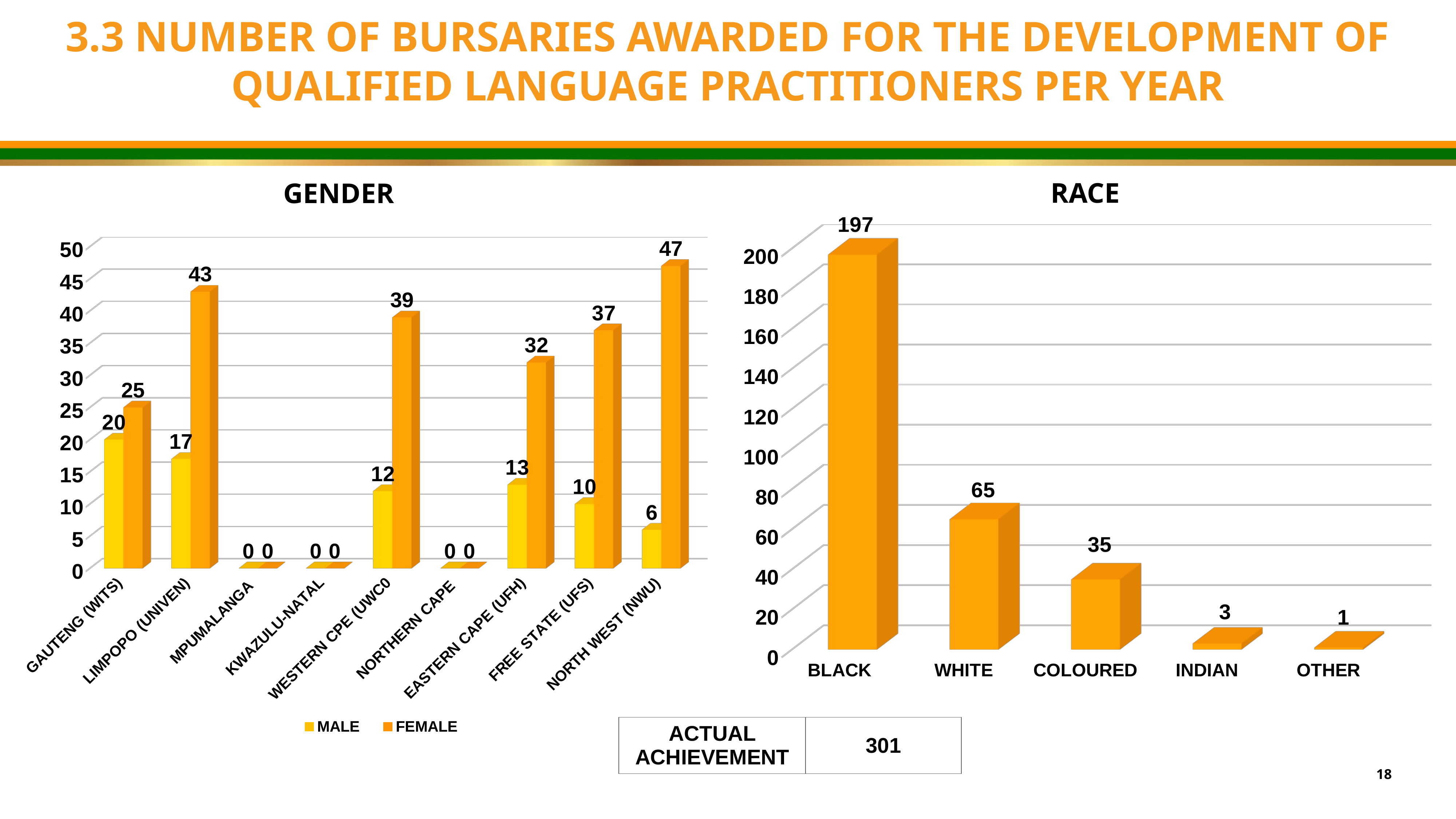
In the GENDER chart, what is the MALE value for GAUTENG (WITS)? 20 In the GENDER chart, which category has the highest FEMALE value? NORTH WEST (NWU) In the RACE chart, which category has the lowest value? OTHER In the RACE chart, what is the value for WHITE? 65 How many series does the legend of the GENDER chart list? 2 What kind of chart is the RACE chart? Bar chart In the GENDER chart, which is larger: the MALE value for EASTERN CAPE (UFH) or the MALE value for FREE STATE (UFS)? EASTERN CAPE (UFH) How many categories are shown on the x axis of the GENDER chart? 9 In the GENDER chart, what is the difference between the FEMALE and MALE values for LIMPOPO (UNIVEN)? 26 In the RACE chart, what is the difference between the values for BLACK and COLOURED? 162 In the GENDER chart, what is the FEMALE value for NORTH WEST (NWU)? 47 In the RACE chart, do the values rise or fall from left to right along the x axis? Fall